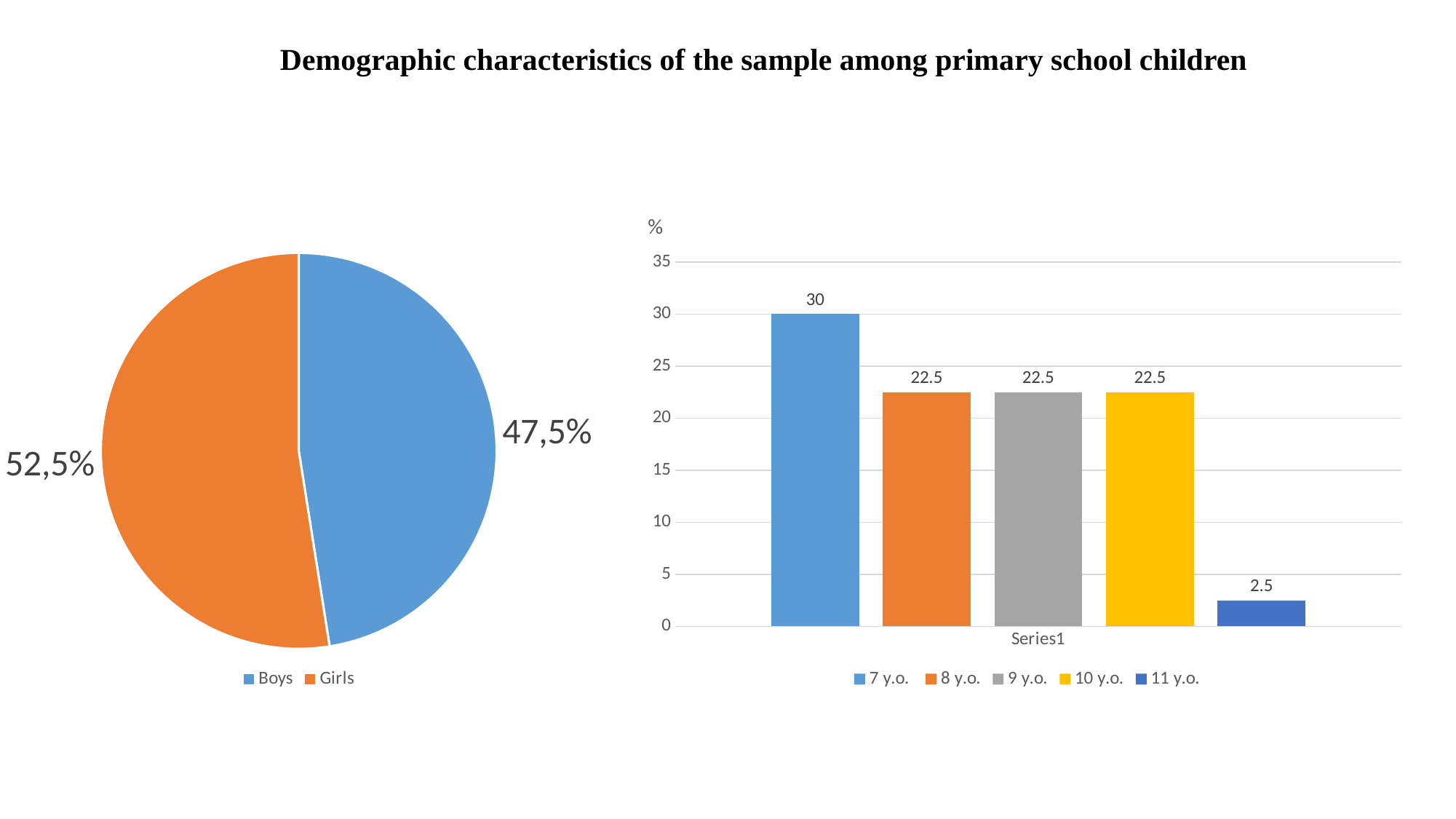
In the pie chart on the left, which group has the larger share, Boys or Girls? Girls In the bar chart on the right, how many series does the legend list? 5 In the pie chart on the left, how many slices are there? 2 In the bar chart on the right, what is the value for 7 y.o.? 30 In the bar chart on the right, what is the difference between the values for 7 y.o. and 8 y.o.? 7.5 In the bar chart on the right, which age group has the highest value? 7 y.o. In the bar chart on the right, which age group has the lowest value? 11 y.o. In the pie chart on the left, what share of the sample is Girls? 52,5% In the pie chart on the left, what share of the sample is Boys? 47,5% In the bar chart on the right, what is the value for 11 y.o.? 2.5 What type of chart is shown on the right side of the slide? Bar chart In the bar chart on the right, what is the value for 9 y.o.? 22.5